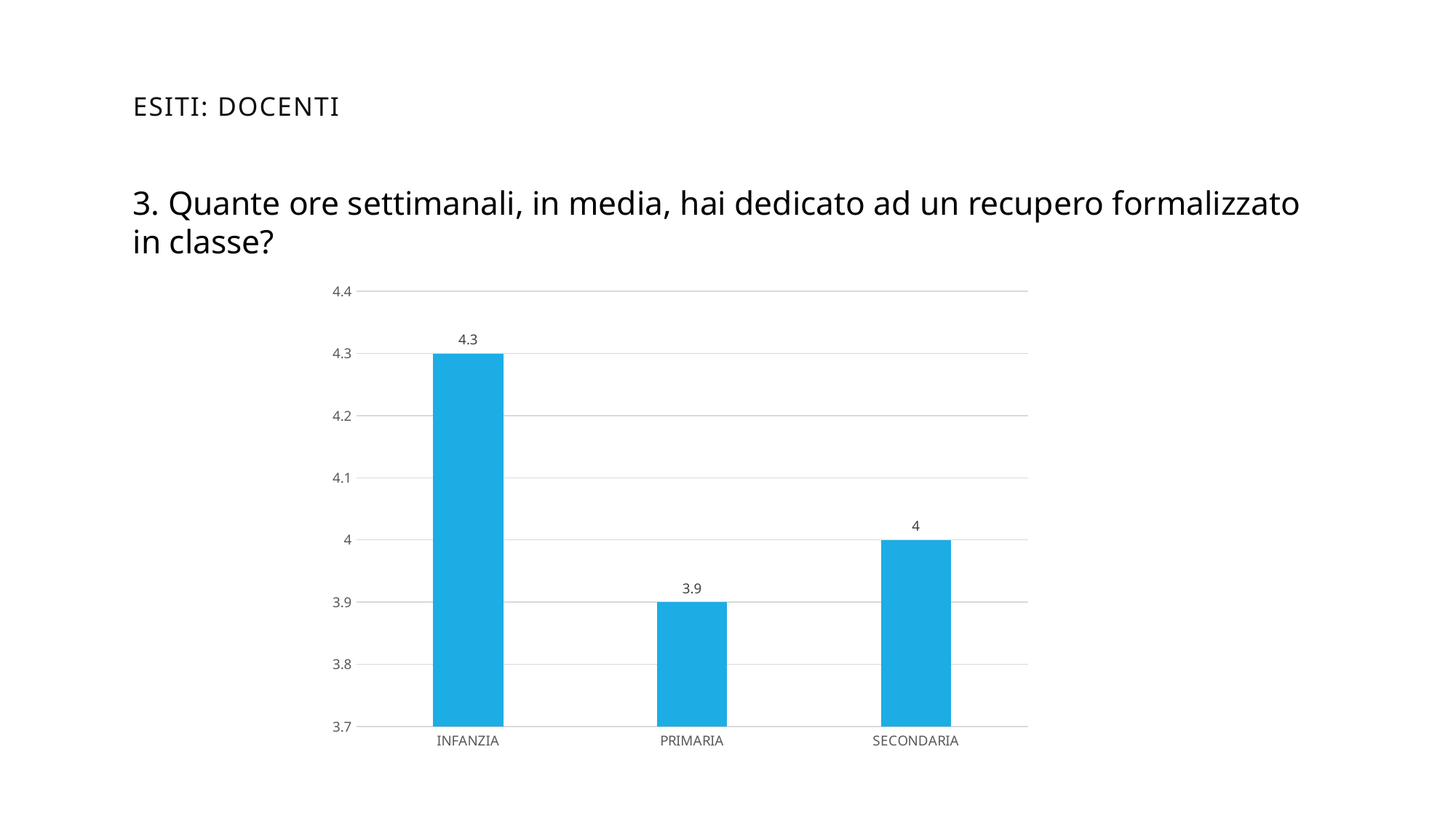
What is the value for SECONDARIA? 4 What kind of chart is shown on the slide? bar chart Which category has the highest value? INFANZIA What is the difference between the values for INFANZIA and PRIMARIA? 0.4 Is the value for INFANZIA greater or less than 4.2? greater Which category has the lowest value? PRIMARIA Which is larger, the value for INFANZIA or the value for SECONDARIA? INFANZIA What is the lowest value shown on the vertical axis? 3.7 What is the difference between the values for SECONDARIA and PRIMARIA? 0.1 What is the value for INFANZIA? 4.3 How many categories are shown on the x axis? 3 What is the value for PRIMARIA? 3.9